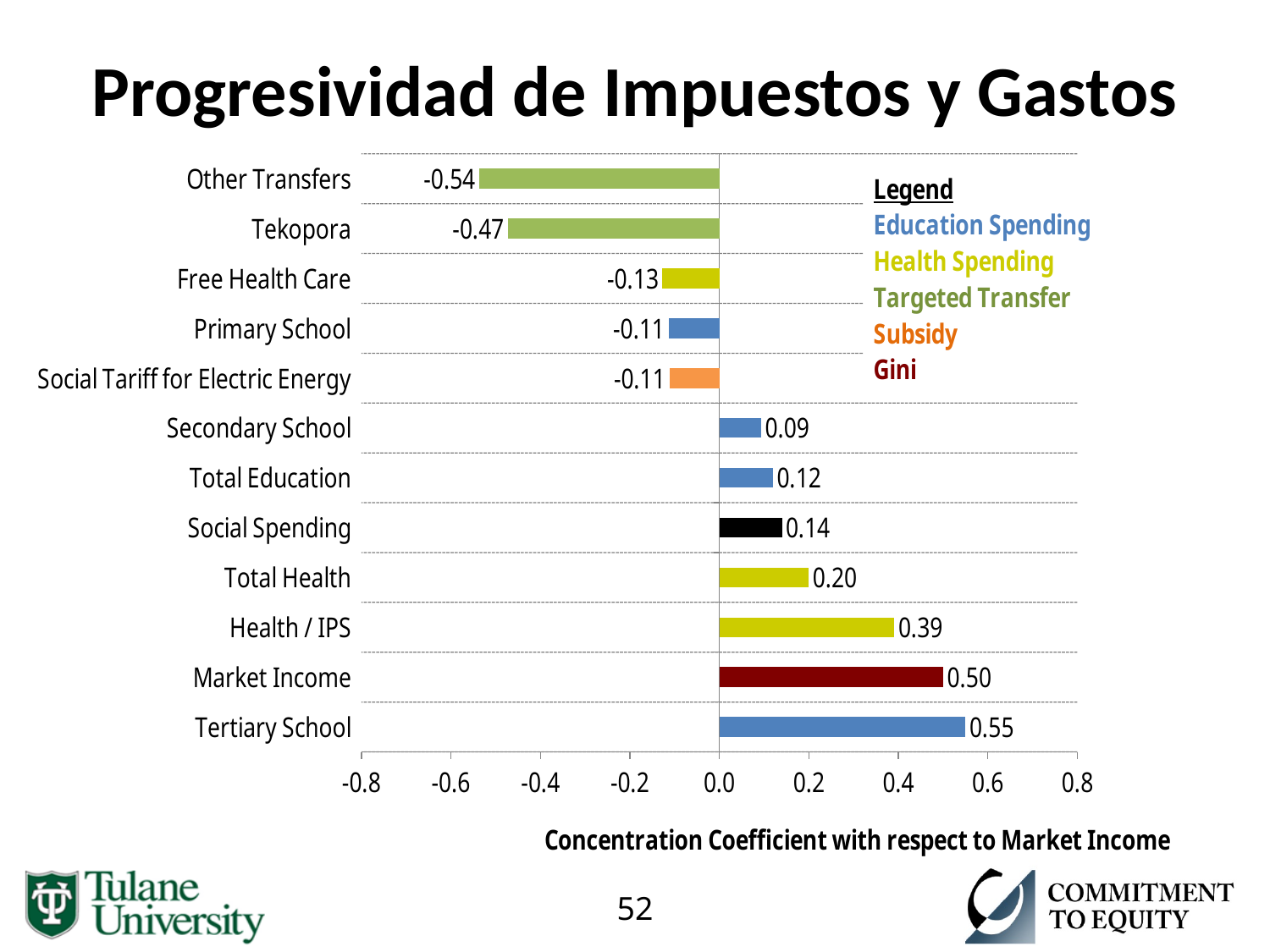
What kind of chart is shown on the slide? Bar chart How many entries does the legend list? 5 What is the difference between the concentration coefficients of Tertiary School and Market Income? 0.05 What is the concentration coefficient for Health / IPS? 0.39 Which has a larger concentration coefficient, Total Health or Total Education? Total Health How many categories are plotted in the chart? 12 What is the concentration coefficient for Market Income? 0.50 What is the concentration coefficient for Tertiary School? 0.55 What is the concentration coefficient for Tekopora? -0.47 Which category has the lowest concentration coefficient? Other Transfers What is the label of the horizontal axis? Concentration Coefficient with respect to Market Income Which category has the highest concentration coefficient? Tertiary School